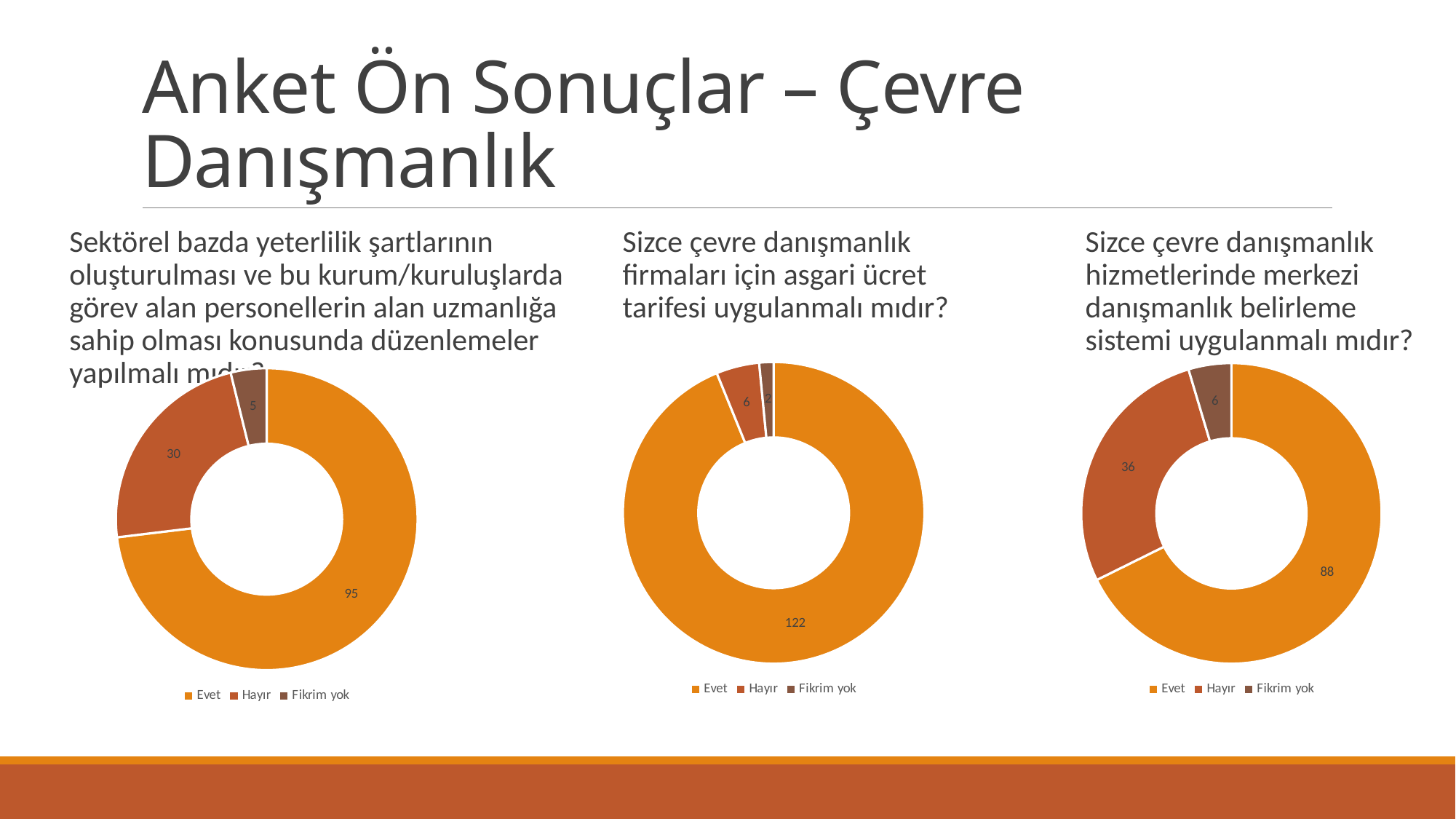
In the left chart, which category has the lowest value? Fikrim yok In the left chart, what is the difference between Evet and Hayır? 65 What is the total of all values in the middle chart? 130 In the left chart, what is the value for Evet? 95 What type of chart is the middle chart? Doughnut chart In the middle chart, which is larger, Hayır or Fikrim yok? Hayır How many categories does the right chart show? 3 In the right chart, what is the value for Fikrim yok? 6 In the right chart, what is the difference between Evet and Hayır? 52 In the right chart, what is the value for Hayır? 36 In the middle chart, what is the value for Hayır? 6 In the middle chart, which category has the highest value? Evet